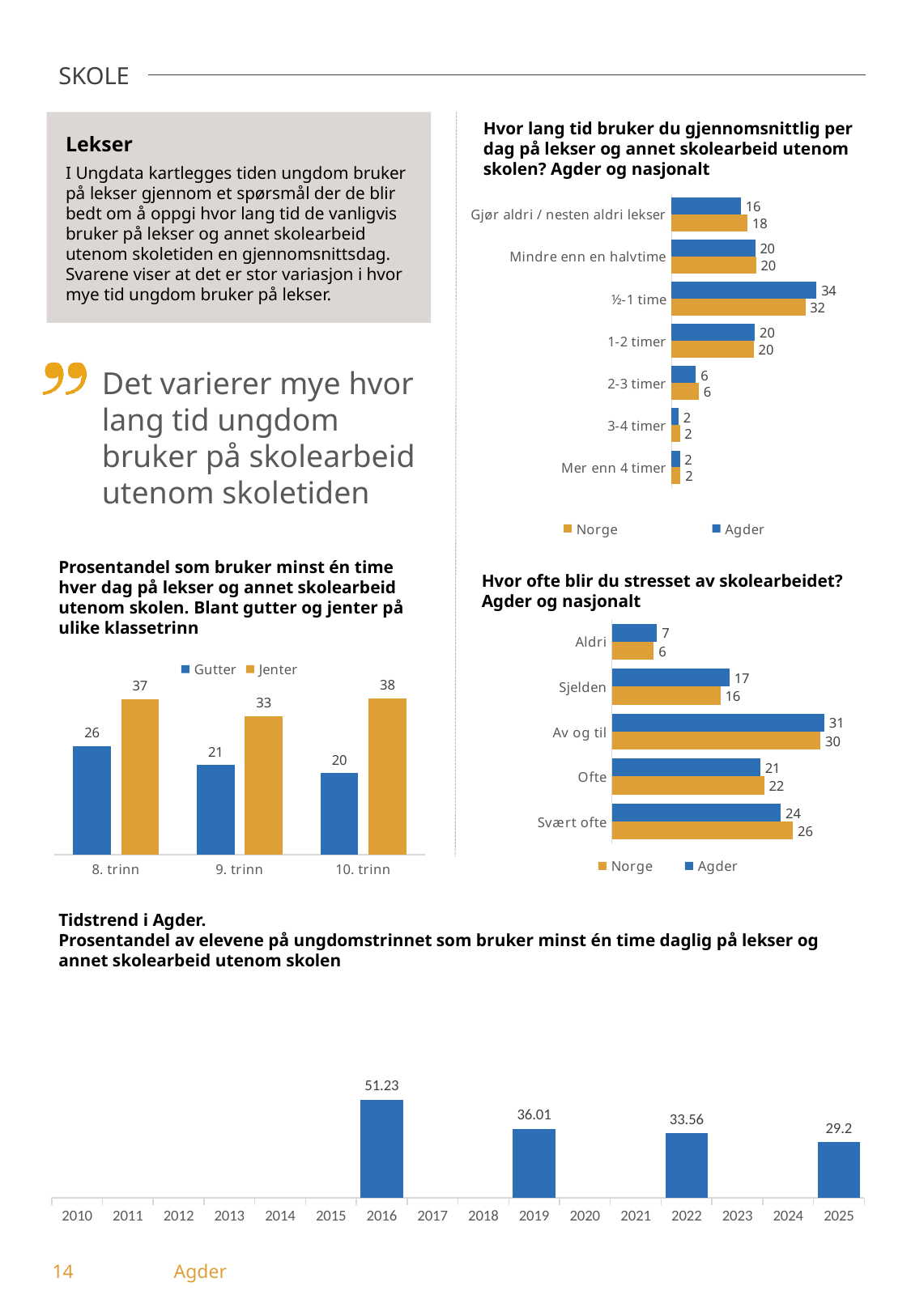
In the chart 'Prosentandel som bruker minst én time hver dag på lekser og annet skolearbeid utenom skolen', which series does the legend list besides Gutter? Jenter In the chart 'Tidstrend i Agder', do the values rise or fall from 2016 to 2025? fall In the chart 'Tidstrend i Agder', what is the value for 2016? 51.23 In the chart 'Hvor lang tid bruker du gjennomsnittlig per dag på lekser og annet skolearbeid utenom skolen?', how many categories are shown? 7 In the chart 'Hvor lang tid bruker du gjennomsnittlig per dag på lekser og annet skolearbeid utenom skolen?', which category has the highest Agder value? ½-1 time In the chart 'Hvor lang tid bruker du gjennomsnittlig per dag på lekser og annet skolearbeid utenom skolen?', what is the Agder value for '½-1 time'? 34 In the chart 'Prosentandel som bruker minst én time hver dag på lekser og annet skolearbeid utenom skolen', what is the value for Jenter in 10. trinn? 38 In the chart 'Hvor lang tid bruker du gjennomsnittlig per dag på lekser og annet skolearbeid utenom skolen?', what is the Norge value for 'Gjør aldri / nesten aldri lekser'? 18 In the chart 'Prosentandel som bruker minst én time hver dag på lekser og annet skolearbeid utenom skolen', what is the difference between Jenter and Gutter in 8. trinn? 11 In the chart 'Hvor ofte blir du stresset av skolearbeidet?', which category has the lowest Agder value? Aldri In the chart 'Hvor ofte blir du stresset av skolearbeidet?', what is the Norge value for 'Svært ofte'? 26 In the chart 'Hvor ofte blir du stresset av skolearbeidet?', is the Agder value for 'Ofte' larger or smaller than the Norge value for 'Ofte'? smaller